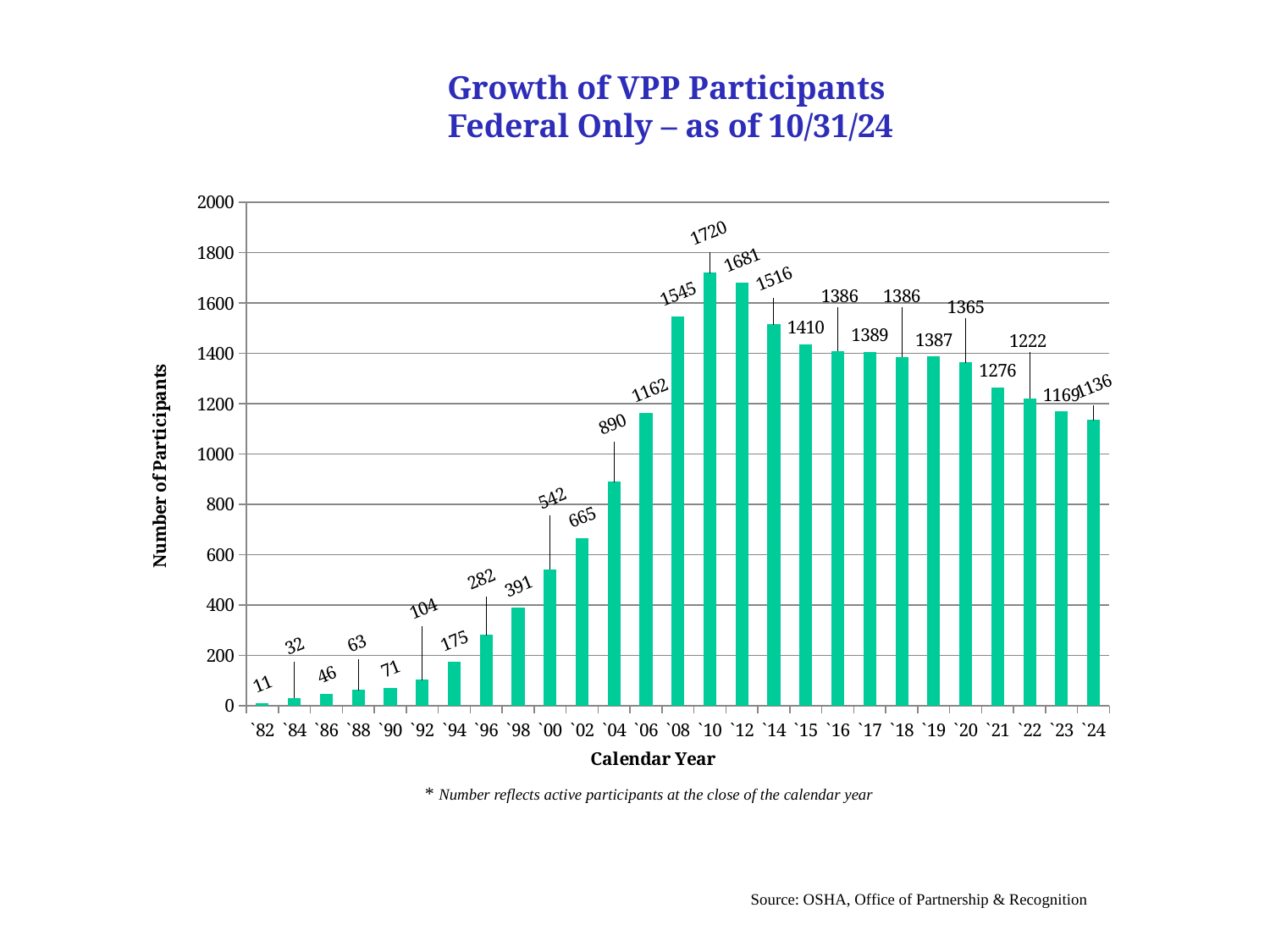
What is the difference between the values for `23 and `24? 33 Which calendar year has the lowest number of participants? `82 Which calendar year has the highest number of participants? `10 What is the difference between the values for `10 and `12? 39 What is the title of the y axis? Number of Participants What kind of chart is this? bar chart What is the number of participants for `10? 1720 How many calendar years are shown on the x axis? 27 Do the values rise or fall from `82 to `10? rise Which has a larger value, `08 or `12? `12 What is the number of participants for `24? 1136 What is the number of participants for `82? 11